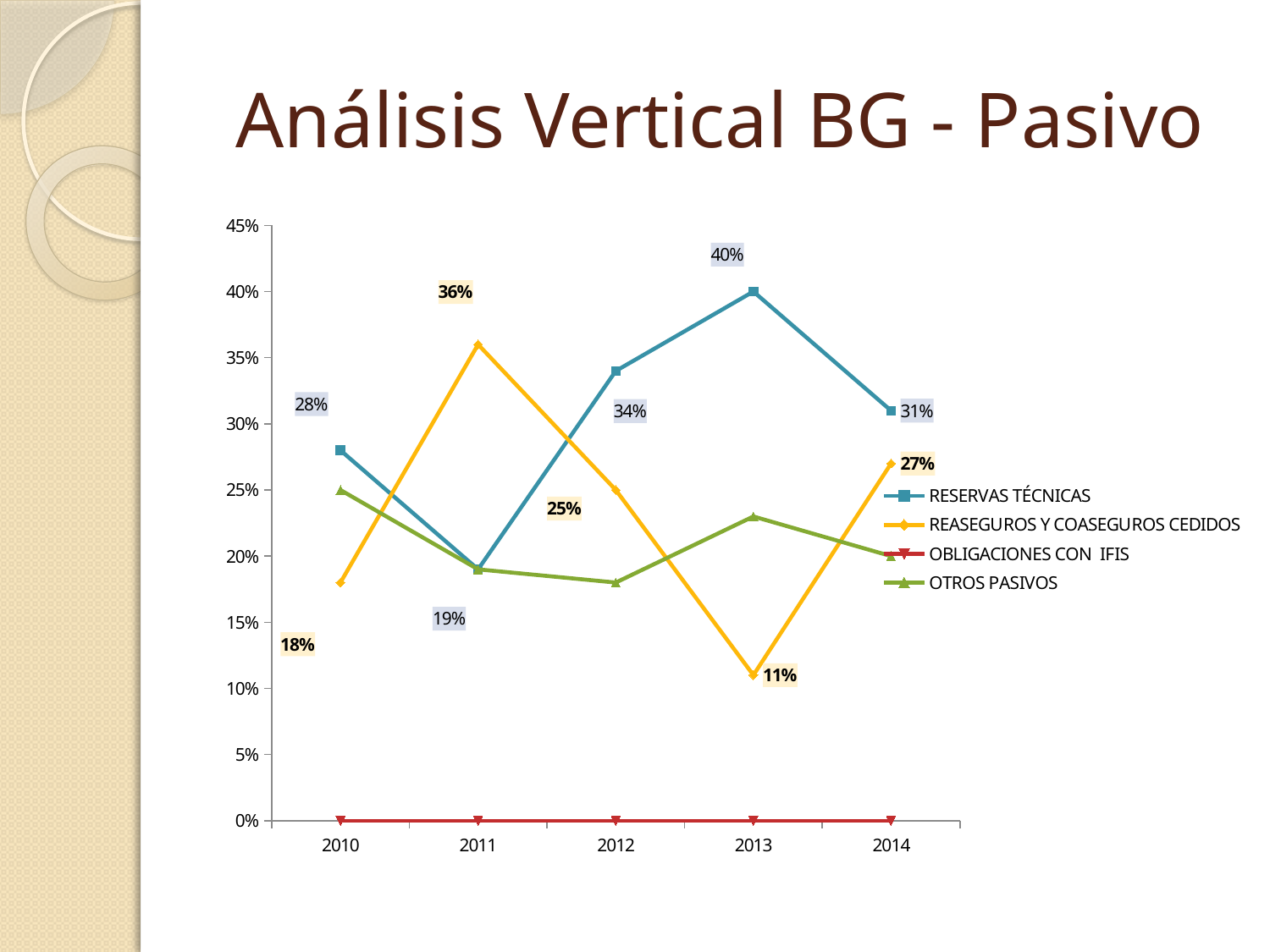
What is the difference between RESERVAS TÉCNICAS in 2013 and in 2014? 9% What is the value of REASEGUROS Y COASEGUROS CEDIDOS in 2013? 11% How many series does the legend list? 4 How many years are shown on the x axis? 5 In which year is REASEGUROS Y COASEGUROS CEDIDOS at its highest? 2011 What is the title of the slide? Análisis Vertical BG - Pasivo In which year is RESERVAS TÉCNICAS at its lowest? 2011 Which is larger in 2012: RESERVAS TÉCNICAS or REASEGUROS Y COASEGUROS CEDIDOS? RESERVAS TÉCNICAS What is the value of REASEGUROS Y COASEGUROS CEDIDOS in 2011? 36% Is the value for OTROS PASIVOS in 2013 greater or less than 20%? greater What is the value of RESERVAS TÉCNICAS in 2013? 40% What type of chart is shown on the slide? line chart